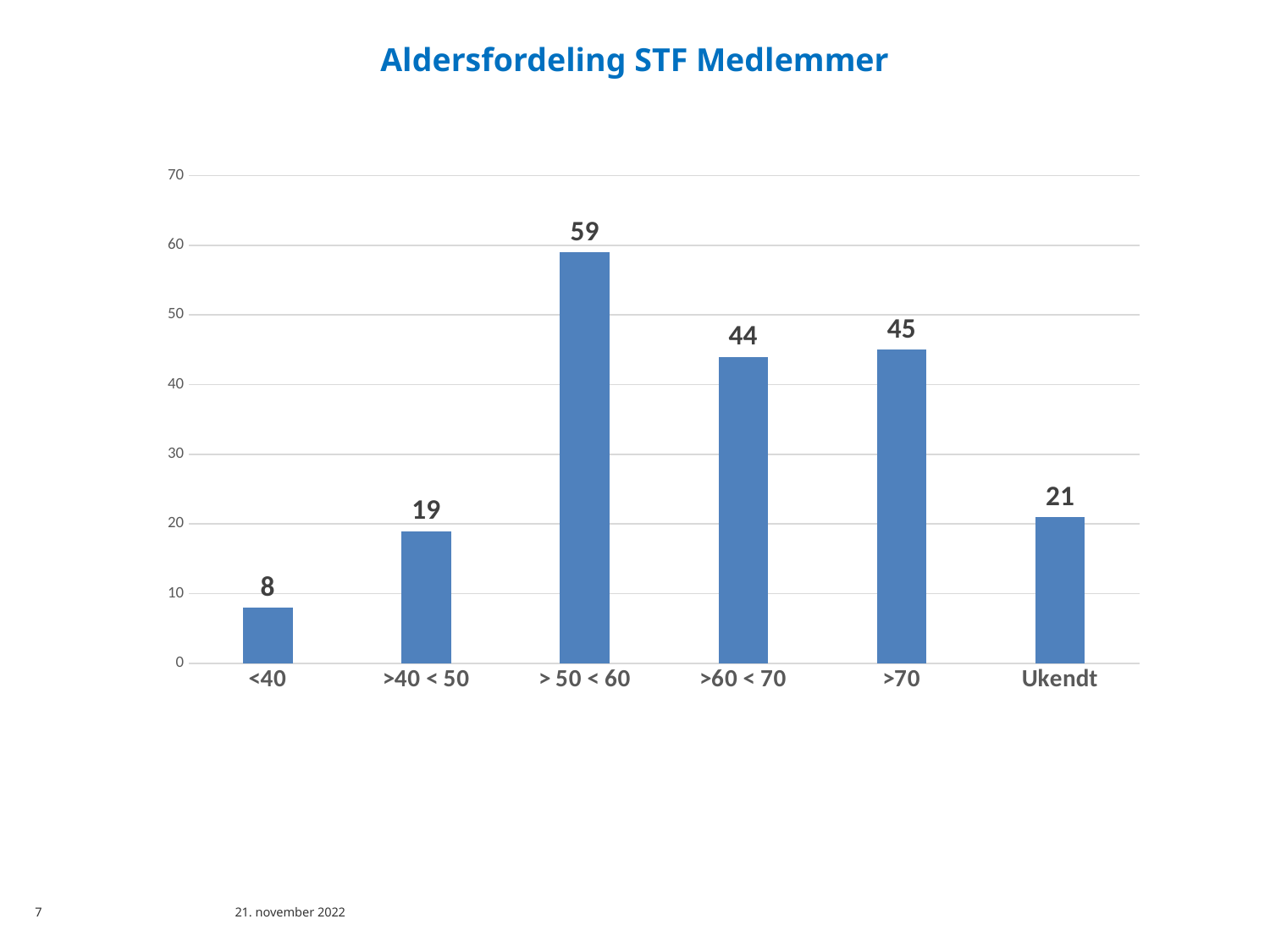
What is the difference between the values for > 50 < 60 and >60 < 70? 15 What is the value for the Ukendt category? 21 Which category has the lowest value? <40 What is the title of the chart? Aldersfordeling STF Medlemmer Which is larger, the value for >70 or the value for >40 < 50? >70 Is the value for >60 < 70 greater or less than 40? greater Which category has the highest value? > 50 < 60 What is the value for the > 50 < 60 category? 59 How many categories are shown on the x axis? 6 What kind of chart is shown on the slide? bar chart What is the difference between the values for Ukendt and >40 < 50? 2 What is the value for the <40 category? 8